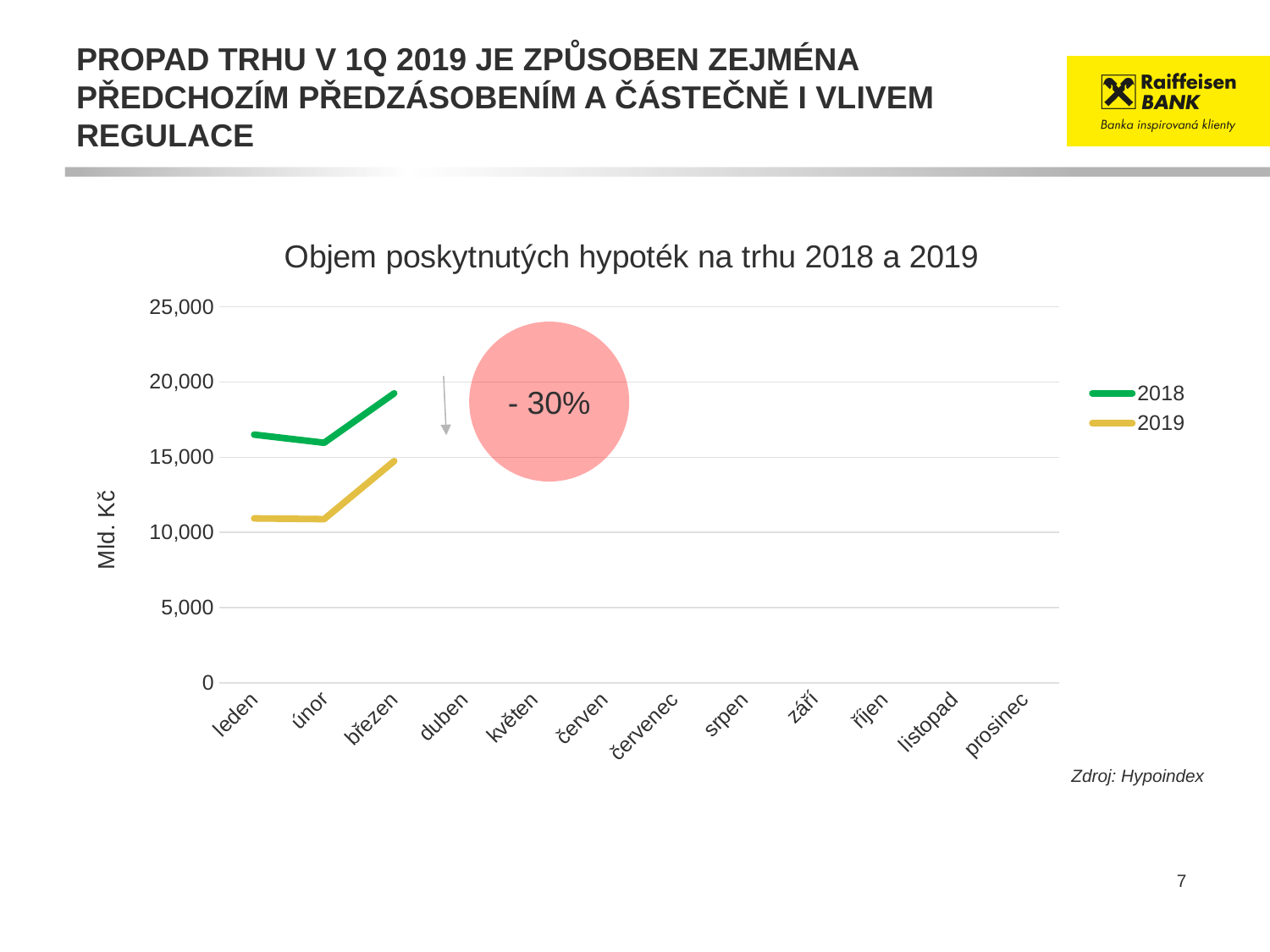
Does the 2019 series rise or fall from únor to březen? rise Is the value for 2019 in březen greater or less than 10,000? greater In which month does the 2018 series reach its highest plotted value? březen Is the value for 2018 in leden greater or less than 15,000? greater What label is shown on the y axis? Mld. Kč How many month categories are shown on the x axis? 12 What kind of chart is shown on the slide? line chart How many series does the legend list? 2 Is the value for 2019 in leden greater or less than 10,000? greater What is the title of the chart? Objem poskytnutých hypoték na trhu 2018 a 2019 In leden, which series has the higher value, 2018 or 2019? 2018